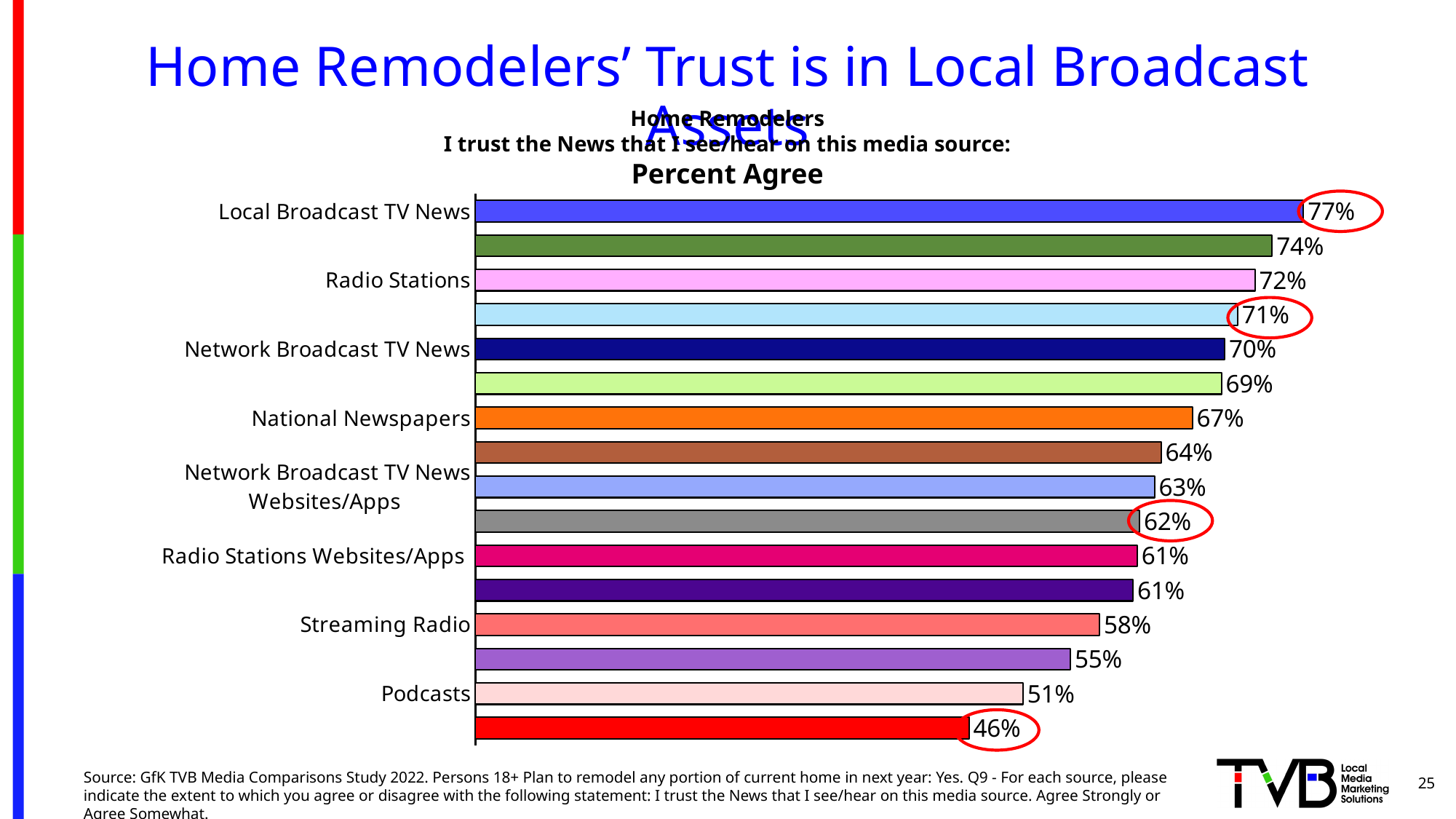
What is the Percent Agree value for National Newspapers? 67% What is the Percent Agree value for Radio Stations? 72% Which labeled media source has the highest Percent Agree? Local Broadcast TV News What is the difference in Percent Agree between Local Broadcast TV News and Network Broadcast TV News? 7 percentage points What percent of home remodelers agree they trust the news on Local Broadcast TV News? 77% What is the Percent Agree value for Podcasts? 51% What is the difference in Percent Agree between Network Broadcast TV News Websites/Apps and Podcasts? 12 percentage points Which has a higher Percent Agree, Radio Stations Websites/Apps or Streaming Radio? Radio Stations Websites/Apps How many bars are plotted on the chart? 16 What is the Percent Agree value for Network Broadcast TV News? 70% What type of chart is shown on the slide? Bar chart What is the lowest Percent Agree value shown on the chart? 46%